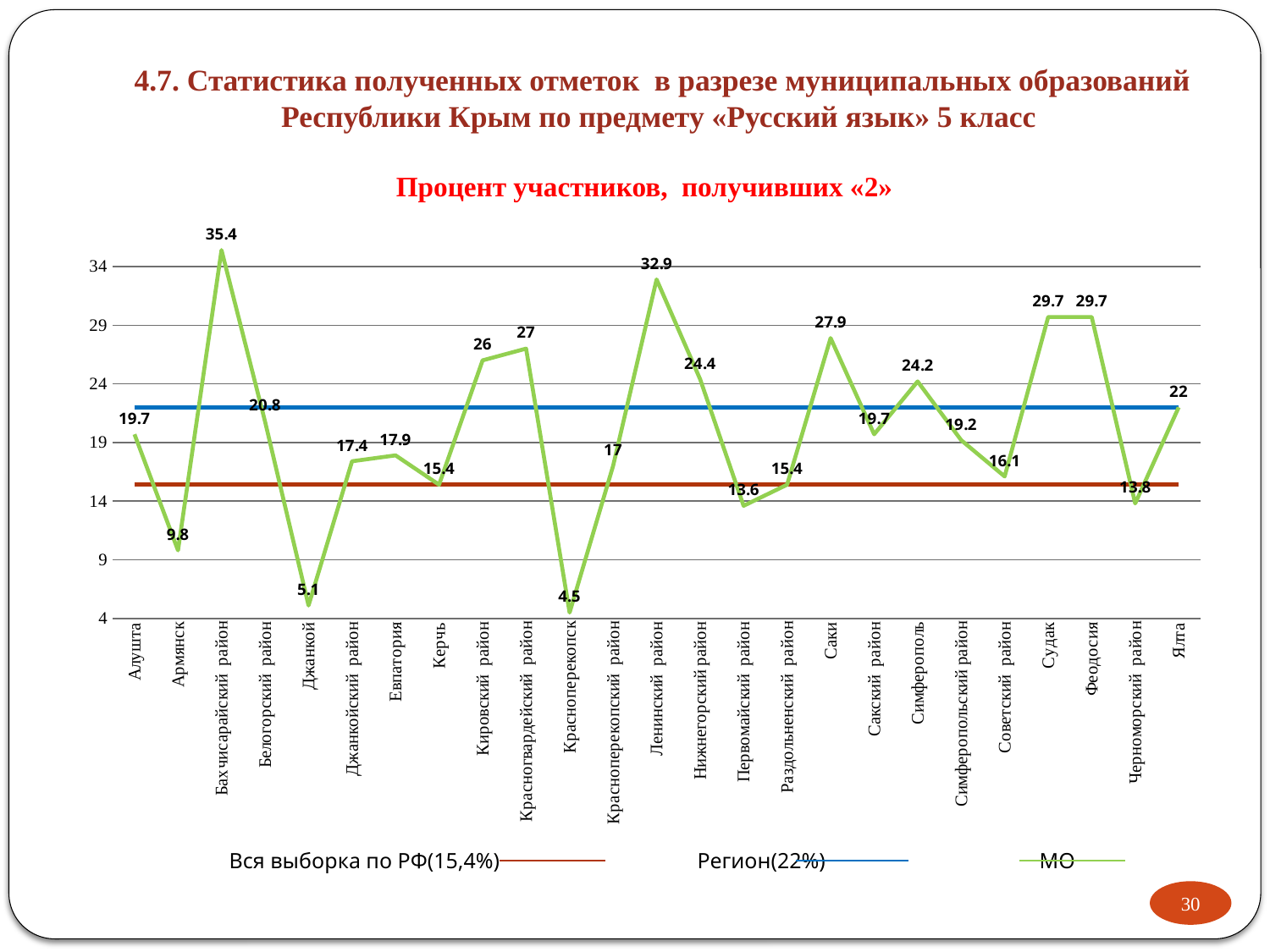
What is the value for Красноперекопск? 4.5 What value is given for the Регион series in the legend? 22% Which is larger, the value for Симферополь or the value for Симферопольский район? Симферополь How many series does the legend list? 3 What kind of chart is shown on the slide? line chart What is the value for Ленинский район? 32.9 Which municipality has the highest percentage of participants who received a «2»? Бахчисарайский район What is the value for Бахчисарайский район? 35.4 Which municipality has the lowest percentage of participants who received a «2»? Красноперекопск How many municipalities are shown on the x axis? 25 What is the difference between the values for Саки and Сакский район? 8.2 Is the value for Джанкой greater or less than 9? less